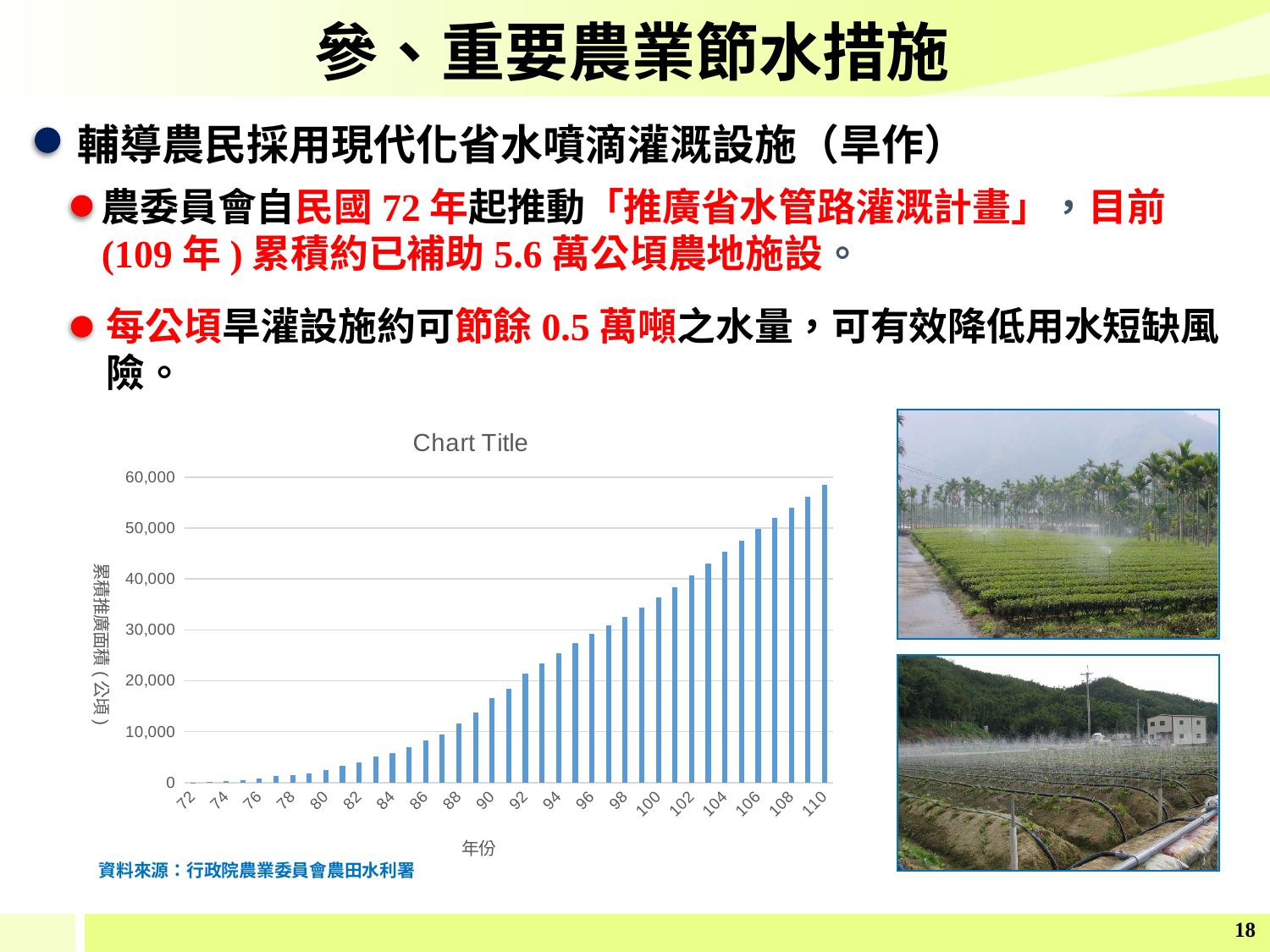
What is the label of the chart's vertical axis? 累積推廣面積(公頃) Which year has the larger value, 90 or 100? 100 What kind of chart is shown on the slide? bar chart Is the value for year 100 greater or less than 30,000? greater Is the value for year 110 greater or less than 50,000? greater Is the value for year 104 greater or less than 40,000? greater Which year has the highest value in the chart? 110 What is the label of the chart's horizontal axis? 年份 Do the values in the chart rise or fall as the year increases along the x axis? rise Which year has the lowest value in the chart? 72